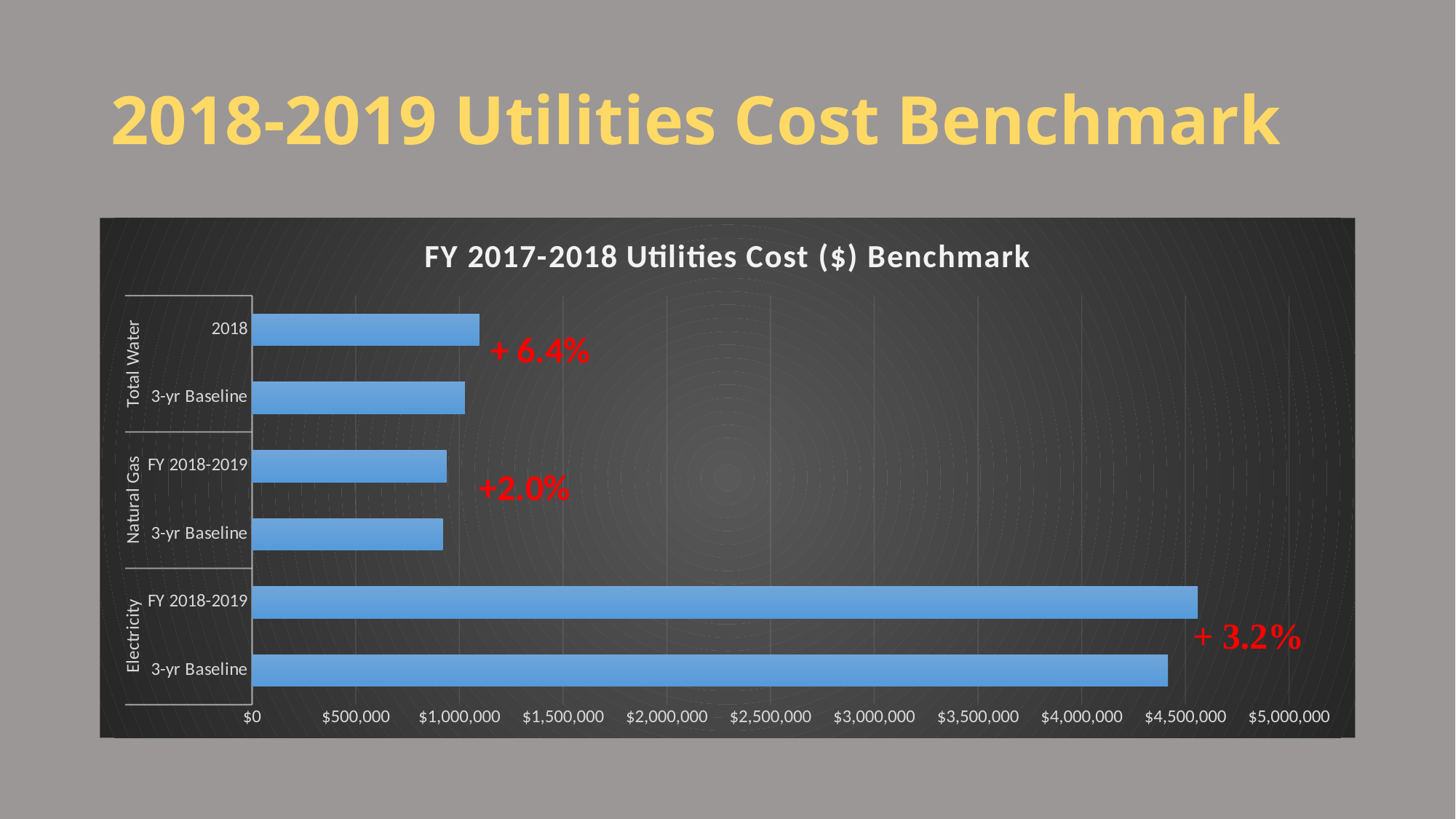
What percentage change is printed next to the Total Water bars? + 6.4% What percentage change is printed next to the Electricity bars? + 3.2% Is the value for Electricity FY 2018-2019 greater or less than $4,000,000? greater What is the title of the chart? FY 2017-2018 Utilities Cost ($) Benchmark Which bar has the highest value in the chart? Electricity FY 2018-2019 Is the value for Total Water 2018 greater or less than $1,000,000? greater Is the value for Natural Gas FY 2018-2019 greater or less than $1,000,000? less What percentage change is printed next to the Natural Gas bars? +2.0% How many bars are plotted in the chart? 6 How many utility categories are shown on the vertical axis? 3 Which is larger, the Total Water 2018 bar or the Natural Gas FY 2018-2019 bar? Total Water 2018 What kind of chart is shown on the slide? bar chart